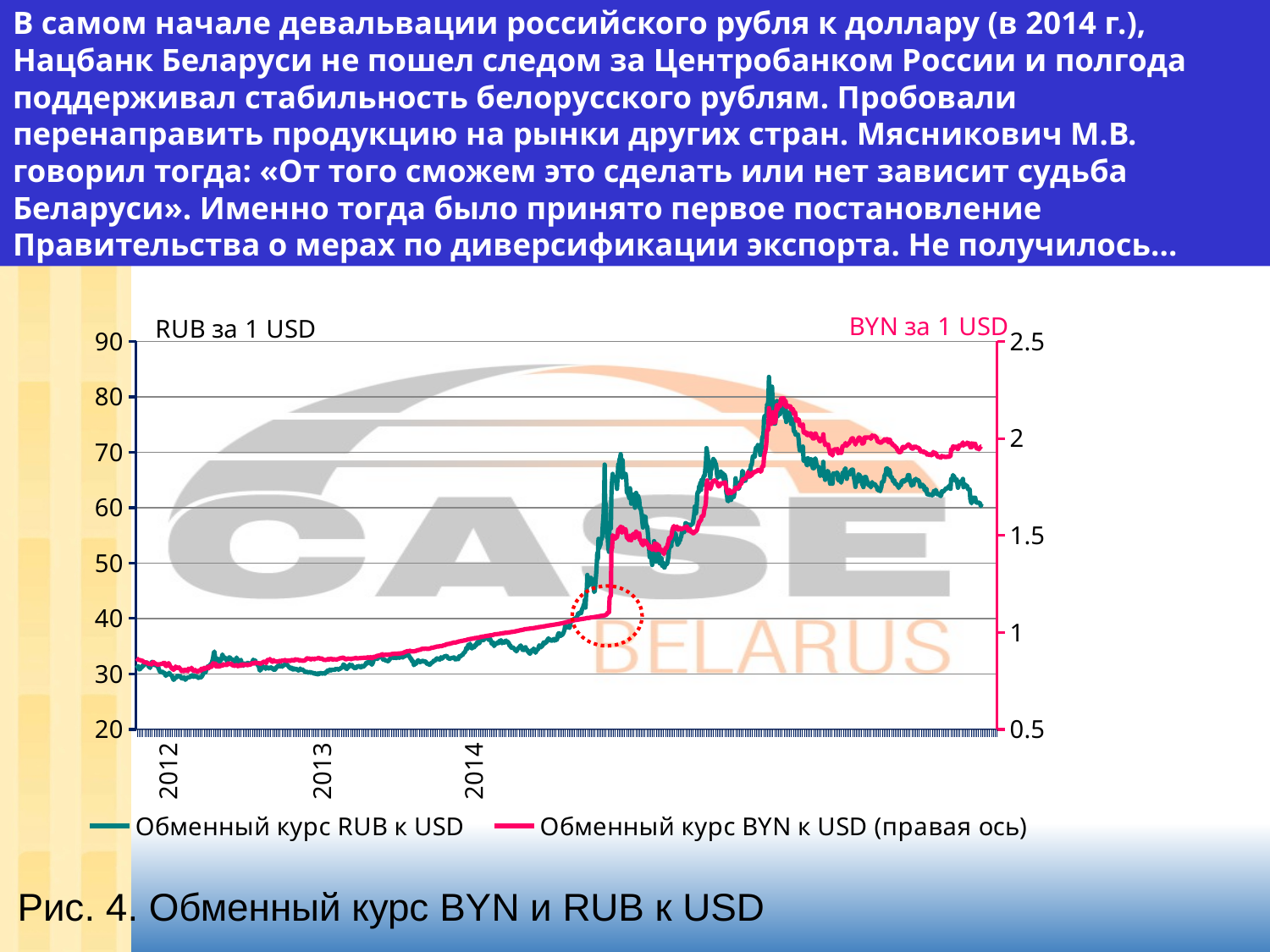
How many year labels are shown on the x axis? 3 Does the RUB per USD exchange rate overall rise or fall from 2012 to the end of the chart? rise Is the BYN per USD value at the right end of the chart greater or less than 1.5? greater What is the label of the left vertical axis? RUB за 1 USD Is the BYN per USD value at the start of 2012 greater or less than 1? less Is the RUB per USD value at the start of 2012 greater or less than 40? less How many series does the legend list? 2 What kind of chart is shown on the slide? line chart Does the BYN per USD exchange rate overall rise or fall from 2012 to the end of the chart? rise Which series is plotted against the right axis according to the legend? Обменный курс BYN к USD